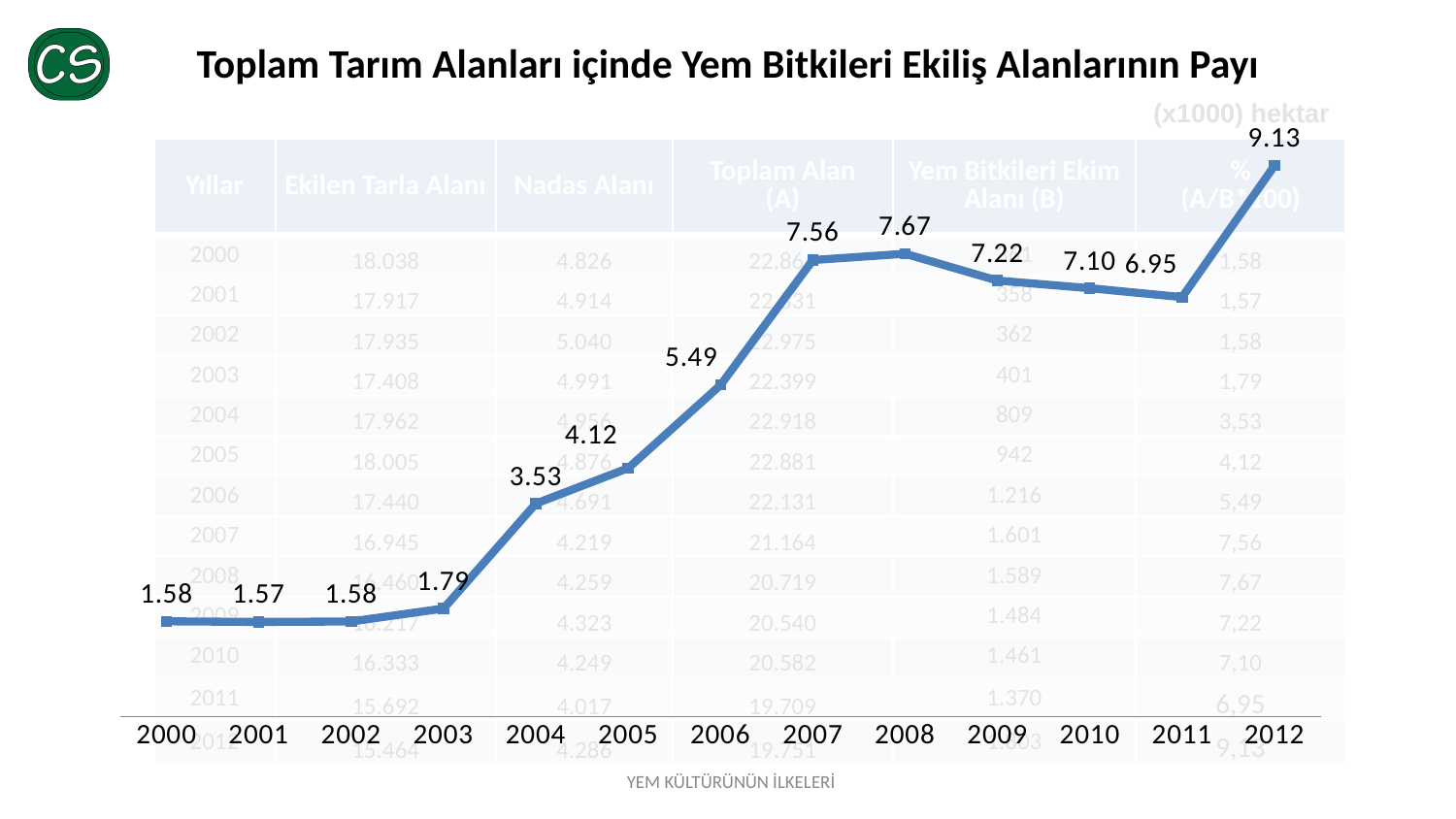
What is the difference between the values for 2012 and 2011? 2.18 Which year has the highest value? 2012 What is the value for 2004? 3.53 What is the difference between the values for 2007 and 2006? 2.07 What is the value for 2008? 7.67 What is the value for 2012? 9.13 Which year has the lowest value? 2001 What is the value for 2011? 6.95 Which is larger, the value for 2005 or the value for 2009? 2009 What is the title of the chart? Toplam Tarım Alanları içinde Yem Bitkileri Ekiliş Alanlarının Payı How many years are plotted on the x axis? 13 What type of chart is shown on the slide? line chart